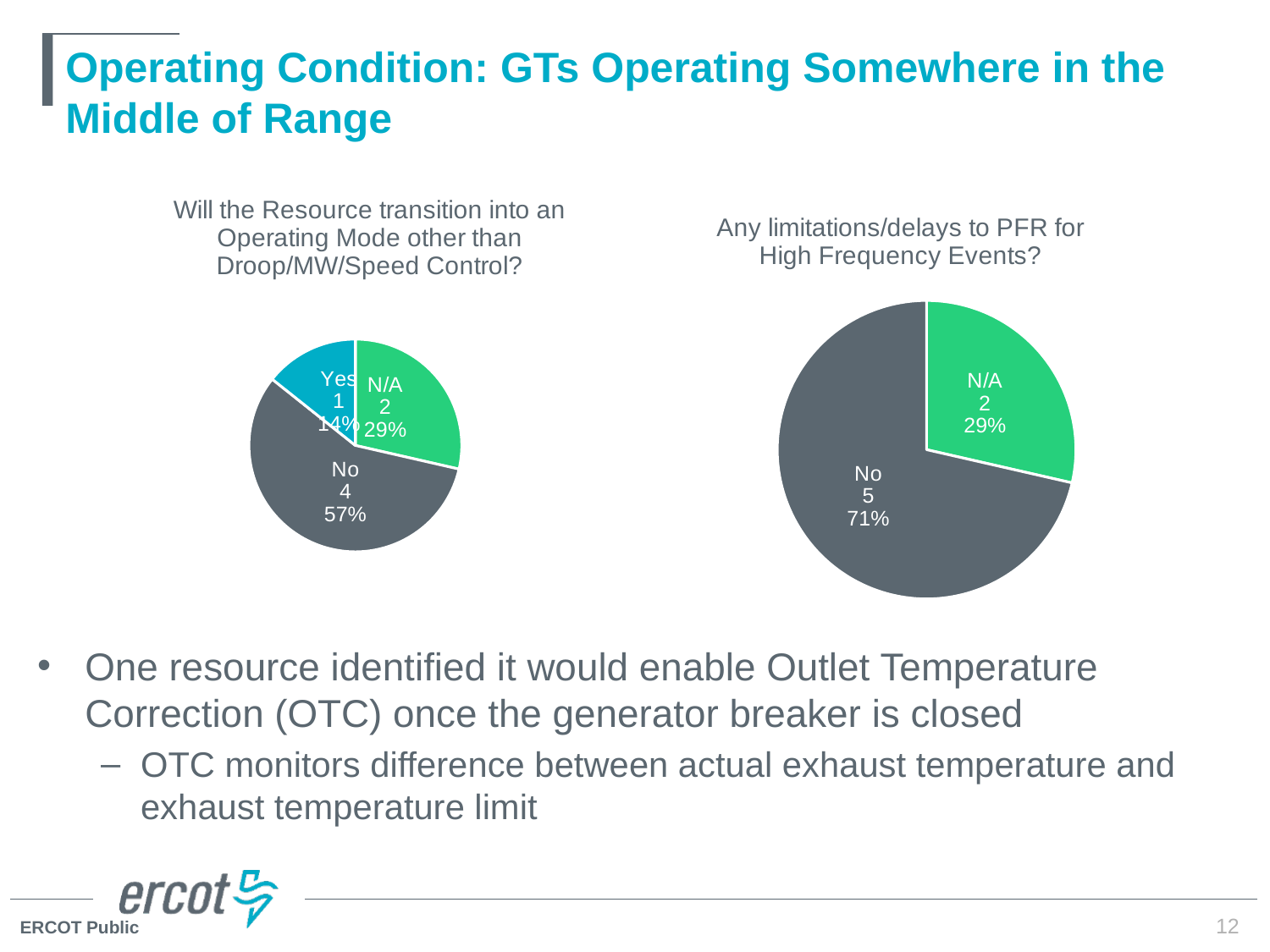
In the right pie chart (Any limitations/delays to PFR for High Frequency Events?), what is the total number of responses across both slices? 7 In the right pie chart (Any limitations/delays to PFR for High Frequency Events?), how many slices are there? 2 In the right pie chart (Any limitations/delays to PFR for High Frequency Events?), what percentage of responses are 'No'? 71% In the left pie chart (Will the Resource transition into an Operating Mode other than Droop/MW/Speed Control?), what is the difference between the 'No' count and the 'N/A' count? 2 In the left pie chart (Will the Resource transition into an Operating Mode other than Droop/MW/Speed Control?), which category has the smallest slice? Yes In the right pie chart (Any limitations/delays to PFR for High Frequency Events?), which is larger, 'No' or 'N/A'? No In the left pie chart (Will the Resource transition into an Operating Mode other than Droop/MW/Speed Control?), which category has the largest slice? No In the left pie chart (Will the Resource transition into an Operating Mode other than Droop/MW/Speed Control?), what percentage of responses are 'N/A'? 29% In the right pie chart (Any limitations/delays to PFR for High Frequency Events?), how many responses are 'No'? 5 What type of chart is used for both charts on the slide? Pie chart In the left pie chart (Will the Resource transition into an Operating Mode other than Droop/MW/Speed Control?), how many slices are there? 3 In the left pie chart (Will the Resource transition into an Operating Mode other than Droop/MW/Speed Control?), how many responses are 'No'? 4